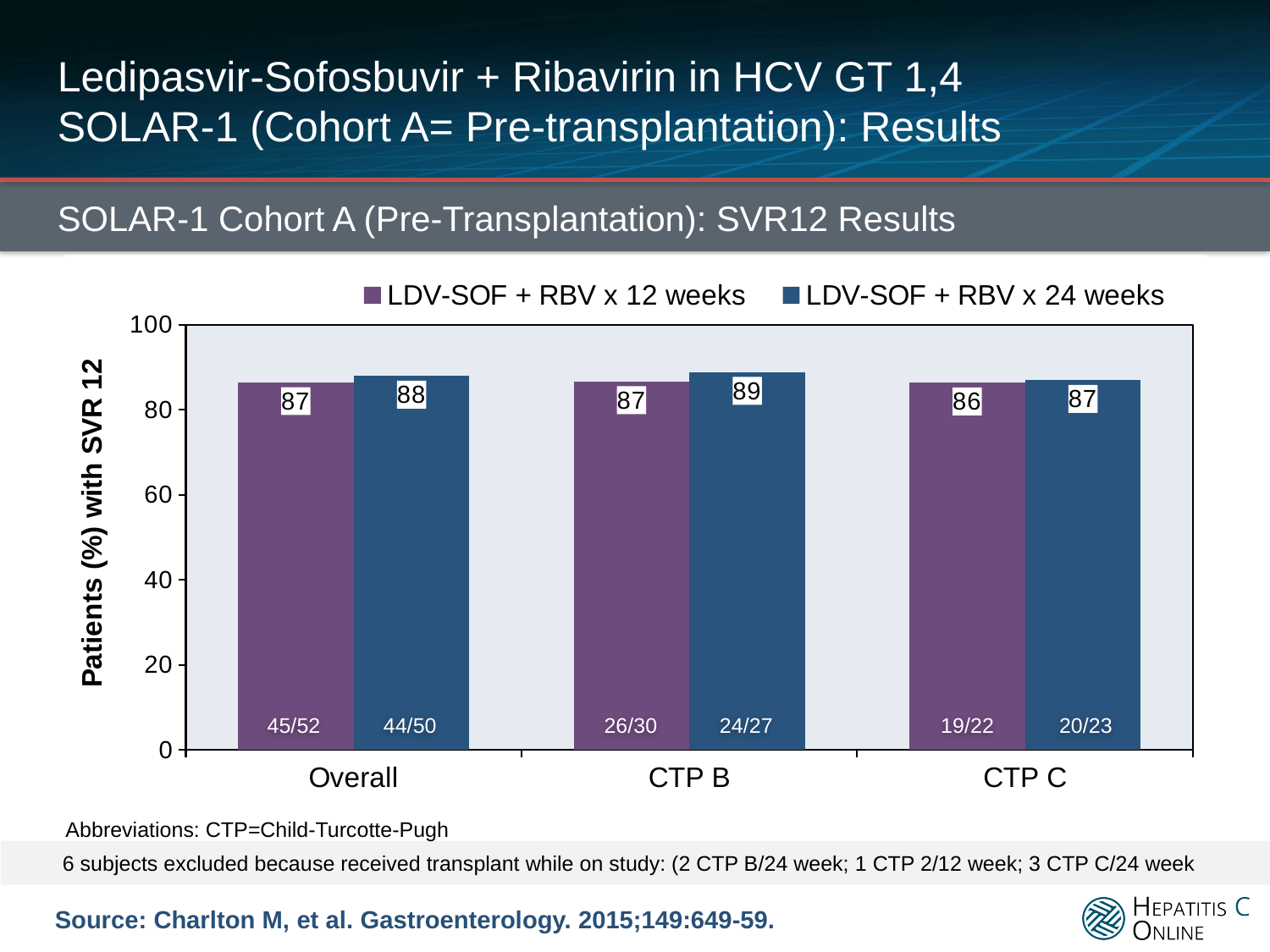
For CTP C, which regimen has the higher SVR12 rate, 12 weeks or 24 weeks? LDV-SOF + RBV x 24 weeks What fraction of patients achieved SVR12 in the Overall group with LDV-SOF + RBV x 24 weeks? 44/50 Which category has the highest SVR12 rate for LDV-SOF + RBV x 24 weeks? CTP B Which category has the lowest SVR12 rate for LDV-SOF + RBV x 12 weeks? CTP C What kind of chart is shown on the slide? Bar chart What is the label of the y axis? Patients (%) with SVR 12 What is the SVR12 rate for CTP C with LDV-SOF + RBV x 12 weeks? 86 What is the SVR12 rate for the Overall group with LDV-SOF + RBV x 12 weeks? 87 How many series does the legend list? 2 How many categories are shown on the x axis? 3 What is the difference between the 24-week and 12-week SVR12 rates for CTP B? 2 What is the SVR12 rate for CTP B with LDV-SOF + RBV x 24 weeks? 89